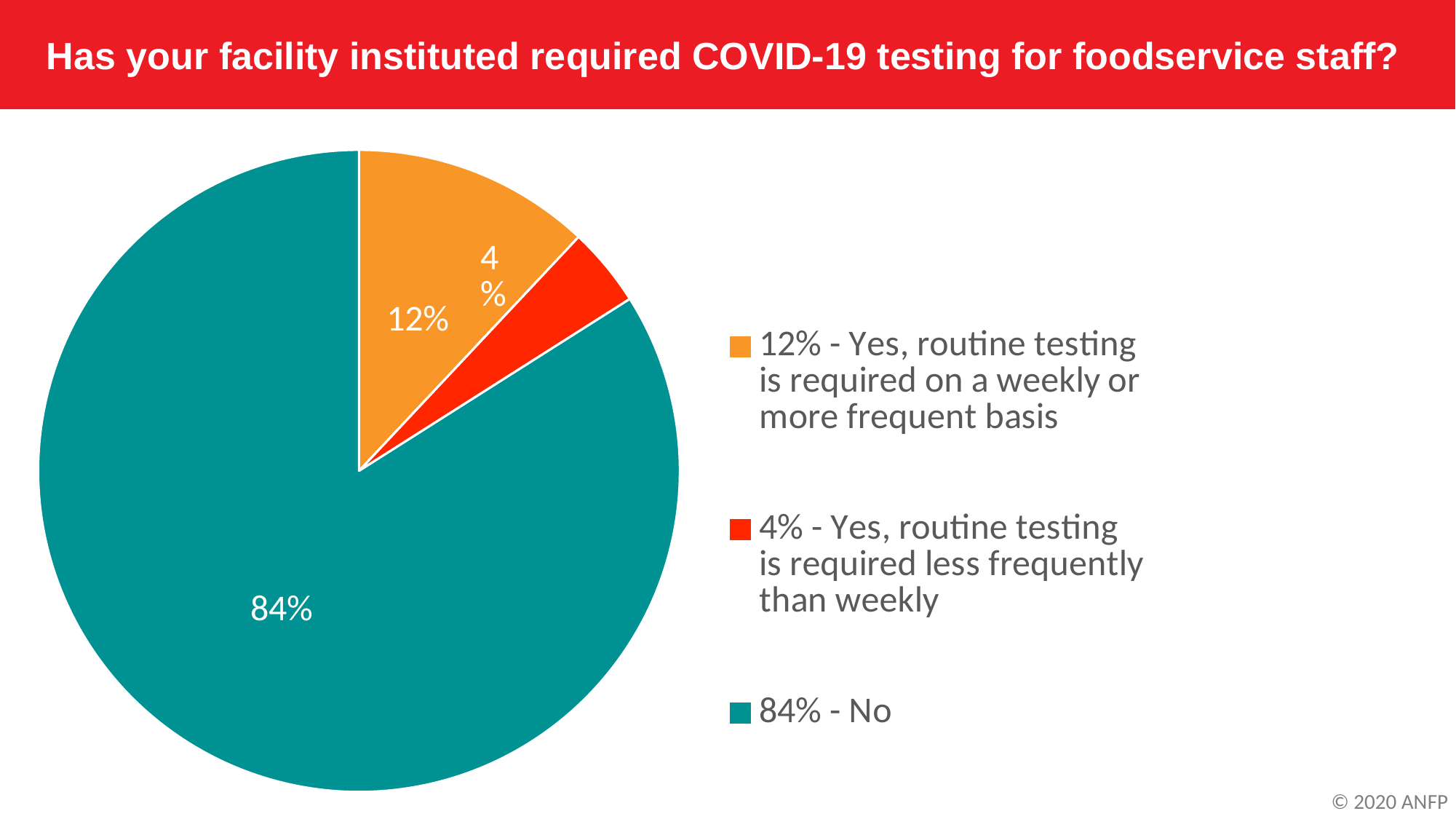
What share of respondents said routine testing is required on a weekly or more frequent basis? 12% What kind of chart is shown on the slide? Pie chart What is the difference in percentage points between the "No" slice and the weekly-or-more-frequent testing slice? 72 Which response has the smallest slice of the pie? Yes, routine testing is required less frequently than weekly What share of respondents answered "No"? 84% Which response has the largest slice of the pie? No What is the title of the chart on the slide? Has your facility instituted required COVID-19 testing for foodservice staff? What colour is the "No" slice of the pie? Teal What share of respondents said routine testing is required less frequently than weekly? 4% How many slices does the pie chart have? 3 What is the difference in percentage points between the weekly-or-more-frequent testing slice and the less-frequently-than-weekly slice? 8 Which is larger: the share for weekly or more frequent testing, or the share for testing less frequently than weekly? Weekly or more frequent testing